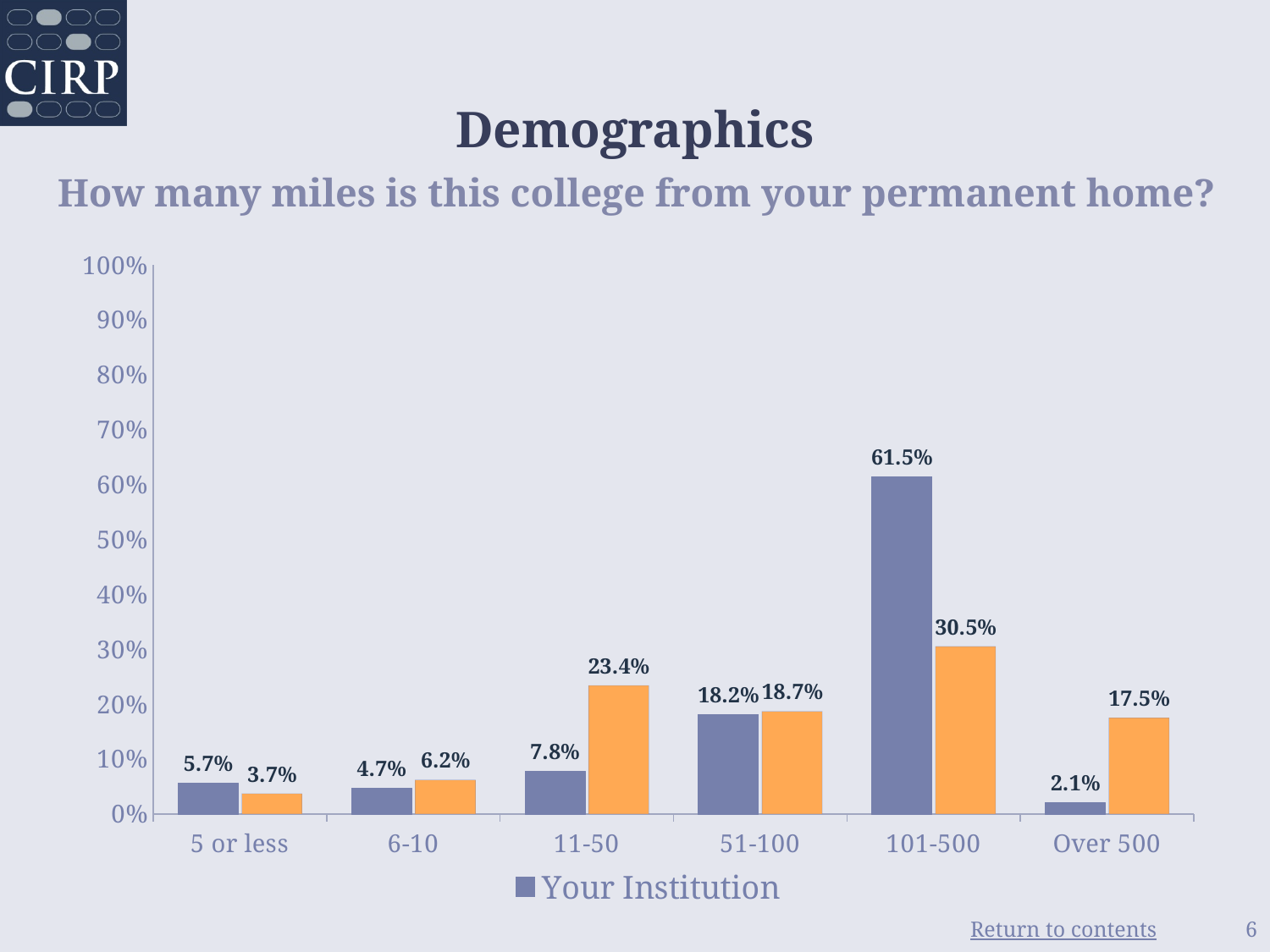
What is the difference between the Your Institution bar and the orange bar in the 101-500 category? 31.0% What is the value shown by the orange bar for the Over 500 category? 17.5% What is the value shown by the orange bar for the 11-50 category? 23.4% Which category has the highest value for Your Institution? 101-500 In the 11-50 category, which is larger: the Your Institution bar or the orange bar? the orange bar What is the value for Your Institution in the 5 or less category? 5.7% Is the value for Your Institution in the 101-500 category greater or less than 50%? greater What kind of chart is shown on the slide? bar chart What is the value for Your Institution in the 101-500 category? 61.5% How many categories are shown on the x axis? 6 Which category has the lowest value for Your Institution? Over 500 What series name is listed in the chart legend? Your Institution